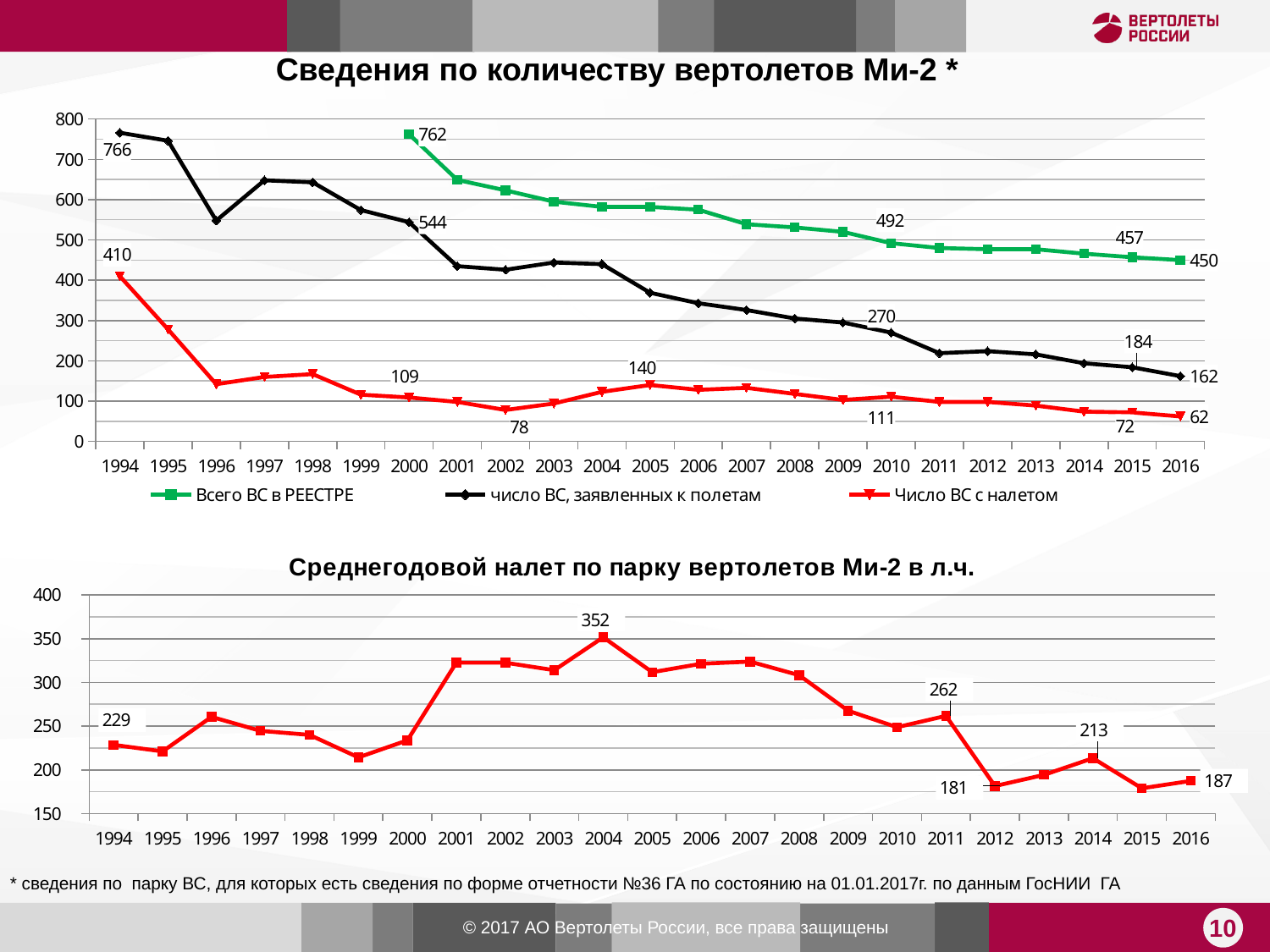
In the bottom chart 'Среднегодовой налет по парку вертолетов Ми-2 в л.ч.', which year has the highest value? 2004 In the top chart 'Сведения по количеству вертолетов Ми-2', is the value of 'Всего ВС в РЕЕСТРЕ' in 2005 greater or less than 500? greater In the top chart 'Сведения по количеству вертолетов Ми-2', how many series does the legend list? 3 In the top chart 'Сведения по количеству вертолетов Ми-2', what is the difference between 'Всего ВС в РЕЕСТРЕ' and 'число ВС, заявленных к полетам' in 2016? 288 In the bottom chart 'Среднегодовой налет по парку вертолетов Ми-2 в л.ч.', what is the difference between the values in 2011 and 2012? 81 In the top chart 'Сведения по количеству вертолетов Ми-2', does 'число ВС, заявленных к полетам' generally rise or fall from 1994 to 2016? fall In the top chart 'Сведения по количеству вертолетов Ми-2', what is the value of 'Всего ВС в РЕЕСТРЕ' in 2000? 762 In the bottom chart 'Среднегодовой налет по парку вертолетов Ми-2 в л.ч.', what is the value in 2004? 352 In the top chart 'Сведения по количеству вертолетов Ми-2', what is the value of 'число ВС, заявленных к полетам' in 1994? 766 In the top chart 'Сведения по количеству вертолетов Ми-2', what is the value of 'Число ВС с налетом' in 2016? 62 In the bottom chart 'Среднегодовой налет по парку вертолетов Ми-2 в л.ч.', how many years are shown on the x axis? 23 What type of chart is the bottom chart 'Среднегодовой налет по парку вертолетов Ми-2 в л.ч.'? line chart